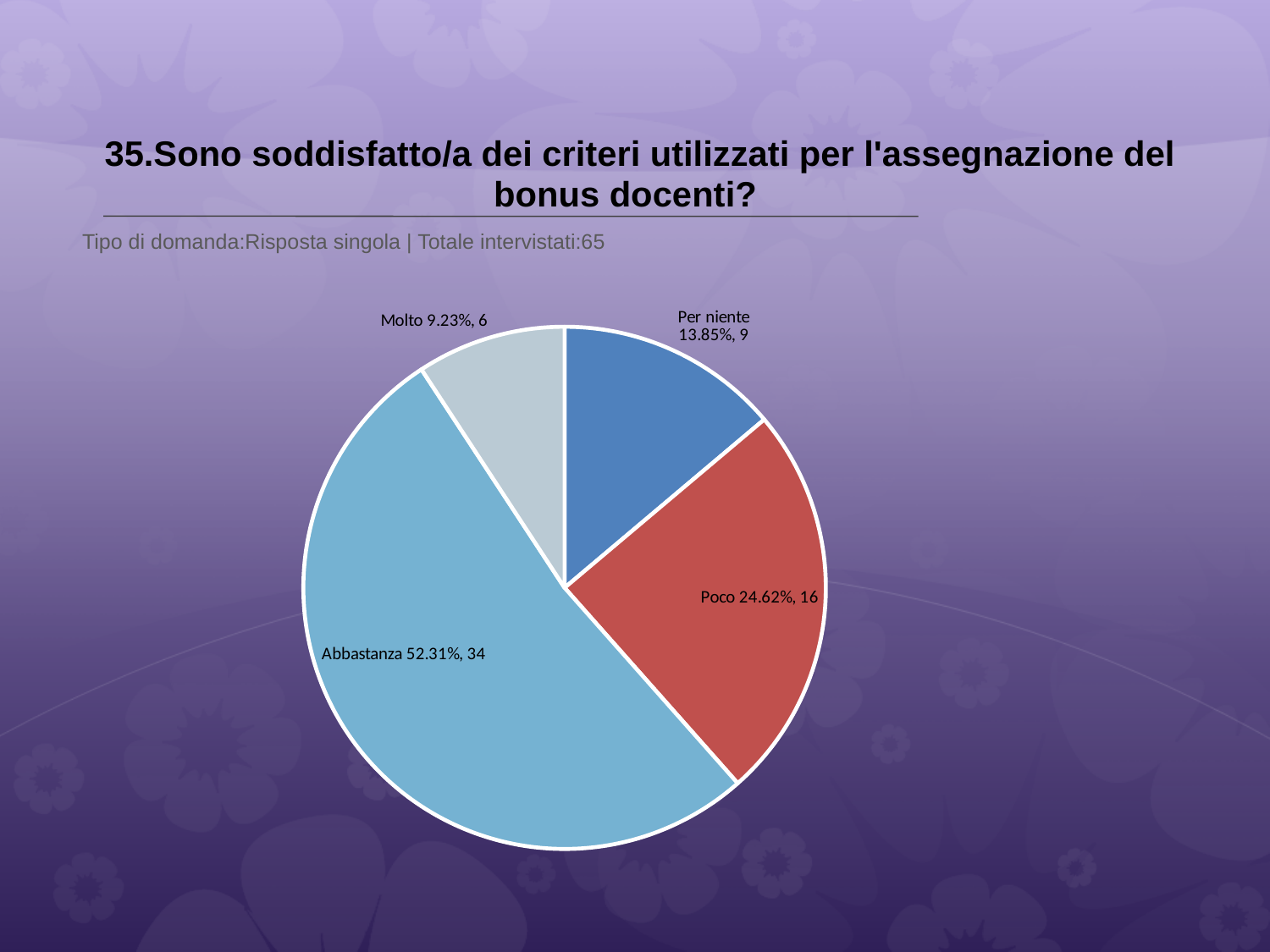
What is the total number of respondents shown on the slide? 65 How many respondents answered "Molto"? 6 What percentage of respondents answered "Abbastanza"? 52.31% How many respondents answered "Poco"? 16 What colour is the "Poco" slice of the pie chart? red Which response has the largest share of the pie? Abbastanza Which response has more respondents, "Poco" or "Per niente"? Poco Which response has the smallest share of the pie? Molto What is the difference in the number of respondents between "Abbastanza" and "Poco"? 18 What kind of chart is shown on the slide? pie chart What percentage of respondents answered "Per niente"? 13.85% How many slices does the pie chart have? 4